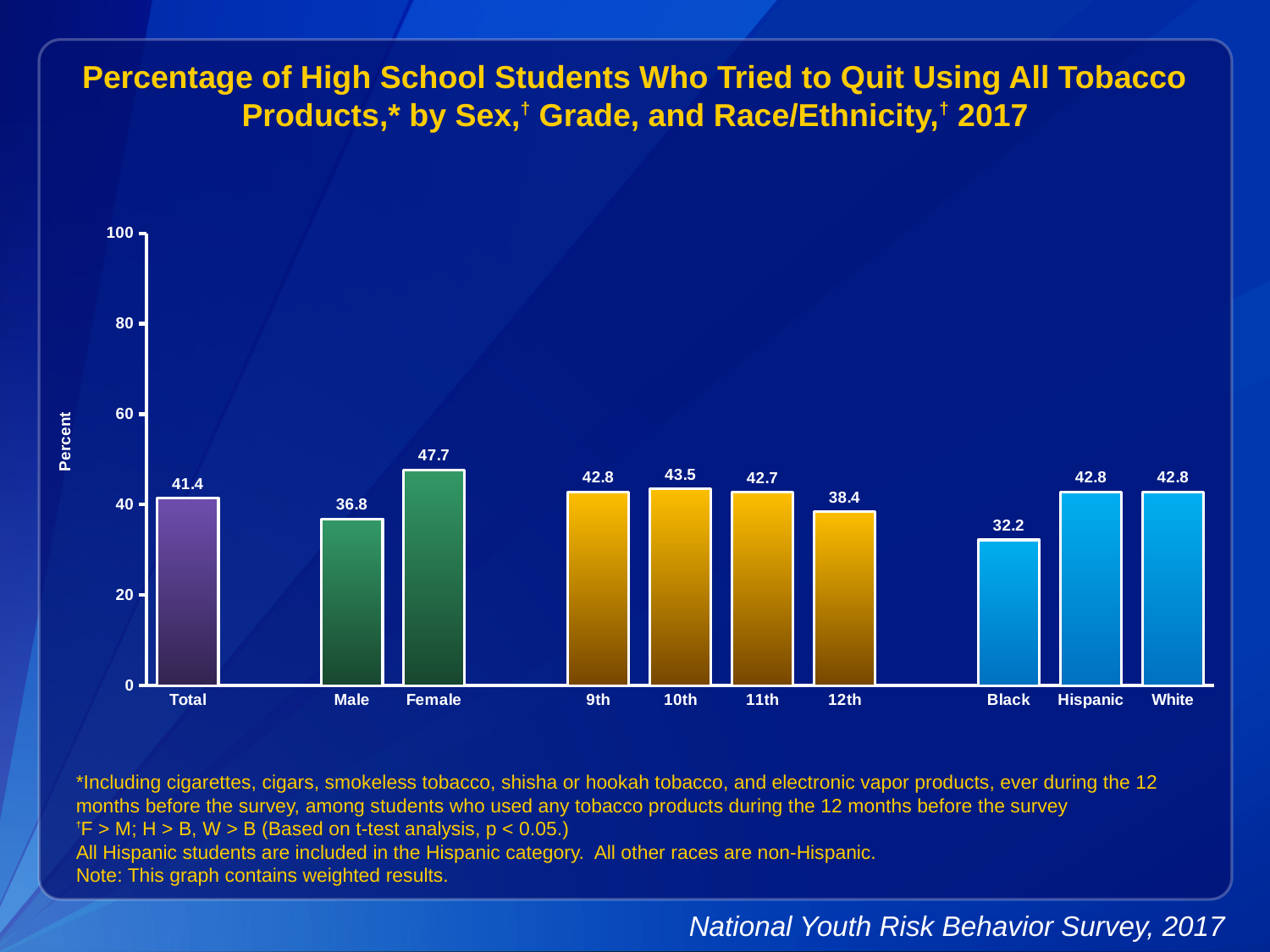
What is the value for Total? 41.4 What is the difference between the Hispanic and Black values? 10.6 What kind of chart is this? bar chart What is the difference between the Female and Male values? 10.9 Which is larger, the value for 10th grade or 12th grade? 10th What is the value for Black students? 32.2 Which category has the highest value? Female How many categories are shown on the x axis? 10 What is the label on the y axis? Percent Is the value for Male greater or less than 40? less Which category has the lowest value? Black What is the value for Female? 47.7